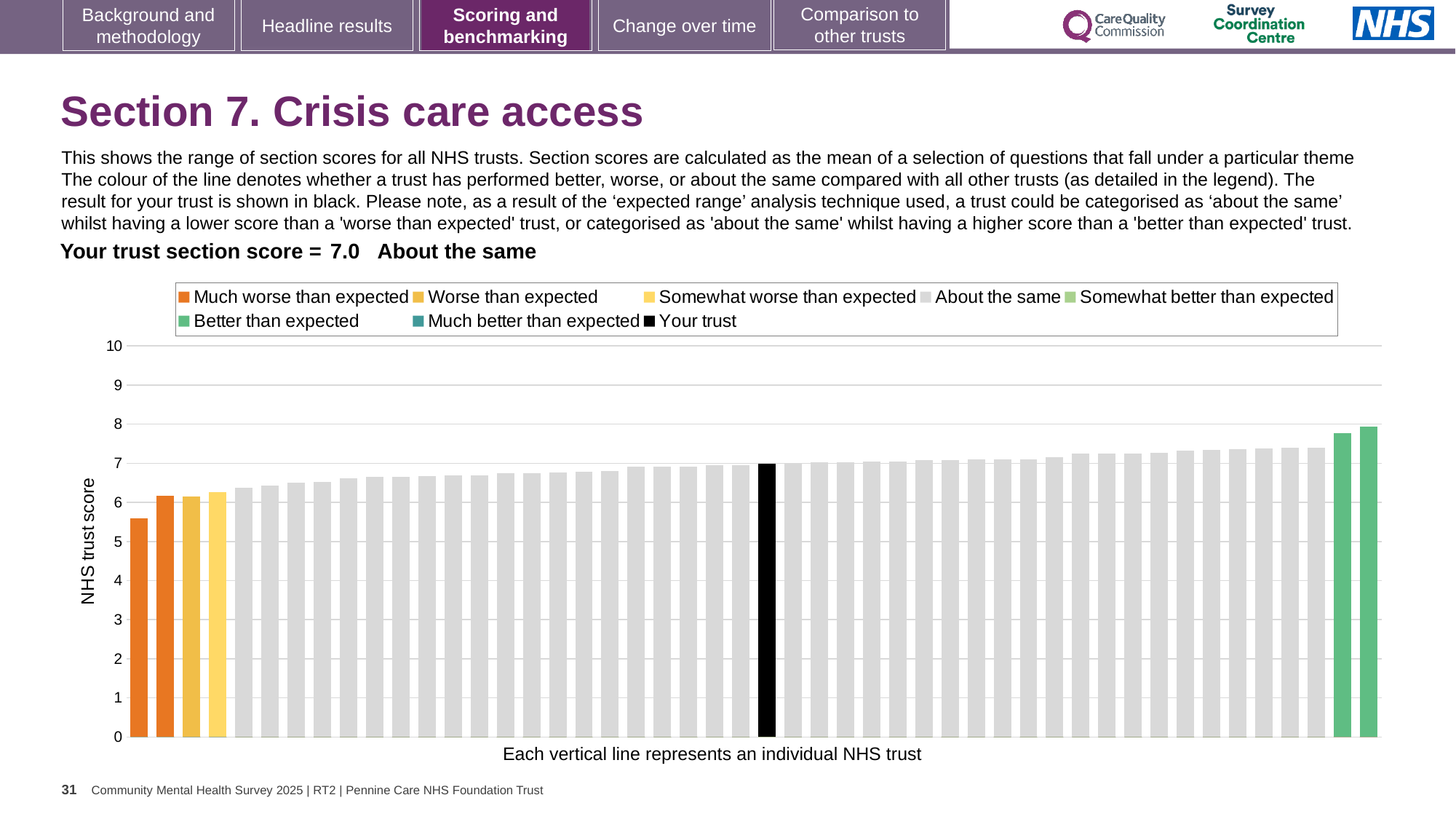
How many entries does the chart legend list? 8 Is the leftmost bar larger or smaller than the black 'Your trust' bar? smaller What kind of chart is shown on the slide? bar chart How many bars are coloured orange (Much worse than expected)? 2 What is the label on the vertical axis of the chart? NHS trust score How many bars are coloured green (Better than expected)? 2 What is the section score for your trust shown on the slide? 7.0 Is the value of the leftmost (lowest) bar greater or less than 6? less Do the bar values rise or fall from left to right along the x axis? rise Is the value of the black 'Your trust' bar greater or less than 6? greater Is the value of the rightmost (highest) bar greater or less than 7? greater Which category is your trust's section score placed in? About the same